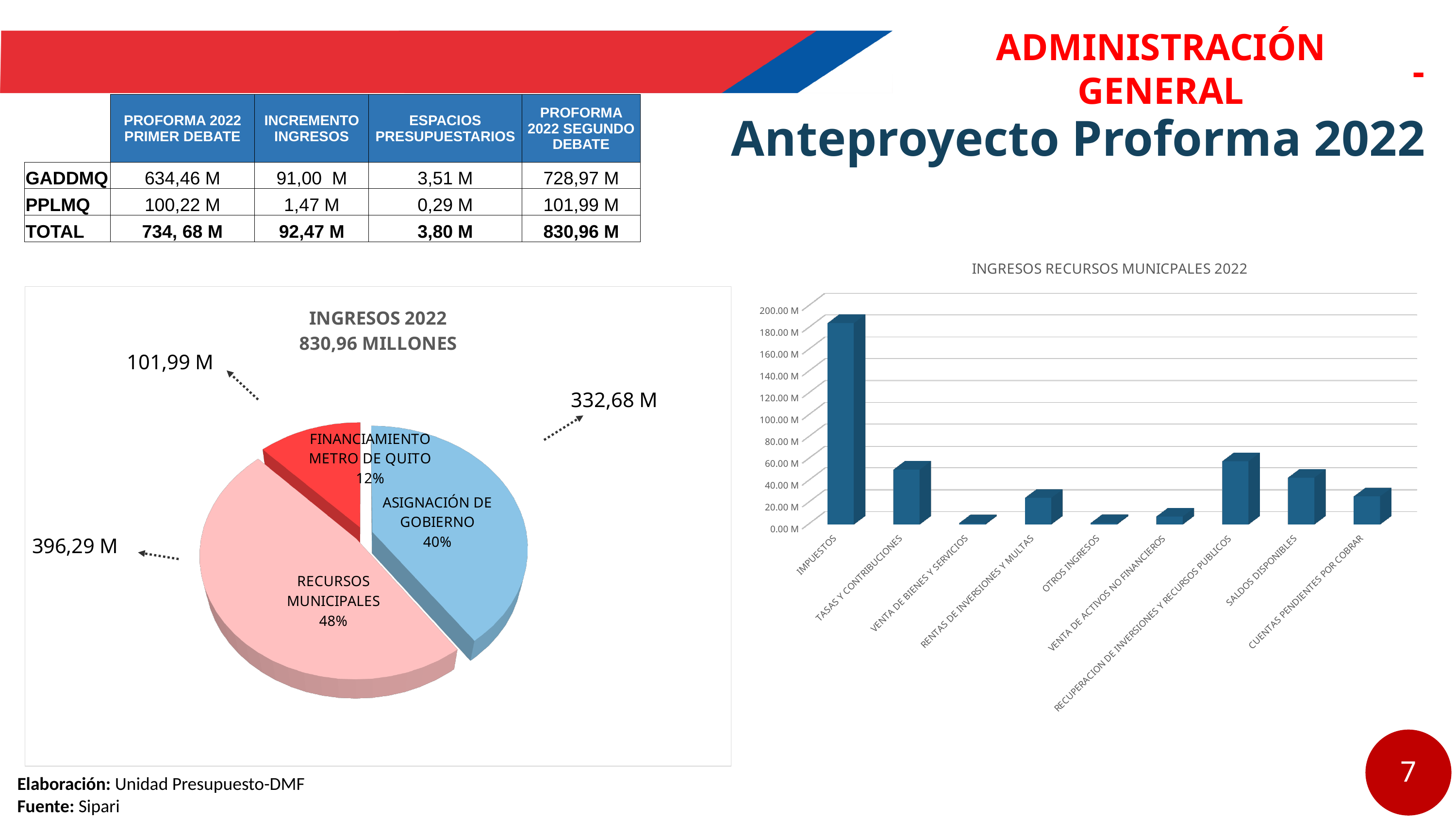
In the chart titled INGRESOS RECURSOS MUNICPALES 2022, which is larger: RECUPERACION DE INVERSIONES Y RECURSOS PUBLICOS or CUENTAS PENDIENTES POR COBRAR? RECUPERACION DE INVERSIONES Y RECURSOS PUBLICOS In the chart titled INGRESOS RECURSOS MUNICPALES 2022, is the value for IMPUESTOS greater or less than 160.00 M? greater In the pie chart titled INGRESOS 2022, what is the value shown for FINANCIAMIENTO METRO DE QUITO? 101,99 M In the pie chart titled INGRESOS 2022, what share does ASIGNACIÓN DE GOBIERNO have? 40% In the chart titled INGRESOS RECURSOS MUNICPALES 2022, what kind of chart is shown? Bar chart In the pie chart titled INGRESOS 2022, how many slices are there? 3 In the pie chart titled INGRESOS 2022, which slice is the largest? RECURSOS MUNICIPALES In the chart titled INGRESOS RECURSOS MUNICPALES 2022, how many categories are shown on the x axis? 9 In the pie chart titled INGRESOS 2022, which slice is the smallest? FINANCIAMIENTO METRO DE QUITO In the pie chart titled INGRESOS 2022, what is the value shown for RECURSOS MUNICIPALES? 396,29 M In the chart titled INGRESOS RECURSOS MUNICPALES 2022, which category has the highest value? IMPUESTOS In the pie chart titled INGRESOS 2022, what share does RECURSOS MUNICIPALES have? 48%